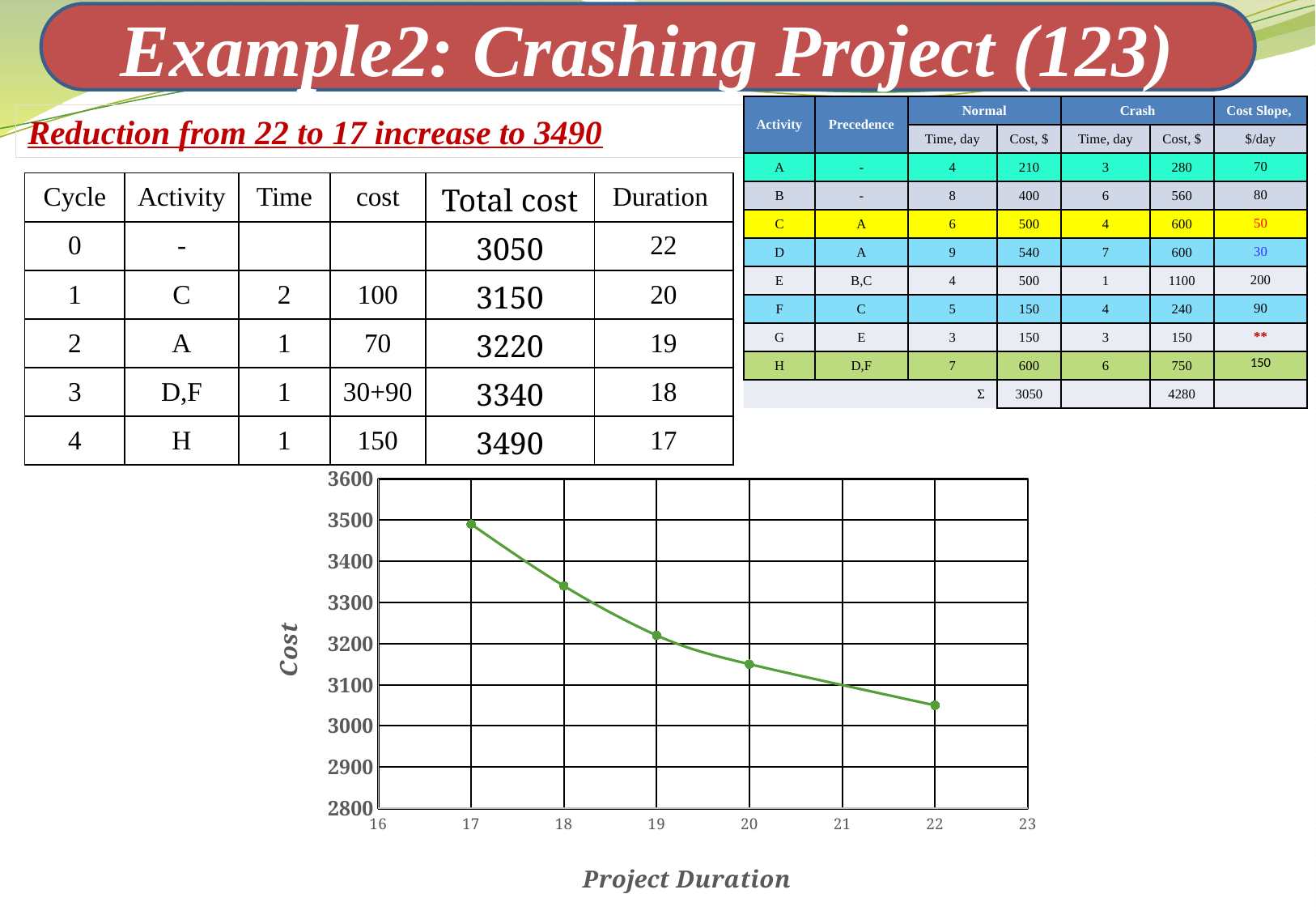
Is the cost at a project duration of 18 greater or less than 3300? greater What kind of chart is shown on the slide? line chart How many data points are plotted on the line chart? 5 Is the cost at a project duration of 22 greater or less than 3100? less Is the cost at a project duration of 17 greater or less than 3400? greater Which has the larger cost on the chart: project duration 18 or project duration 20? 18 What is the label of the y axis of the chart? Cost As project duration increases along the x axis, does the cost rise or fall? fall At which project duration is the plotted cost lowest? 22 At which project duration is the plotted cost highest? 17 What is the label of the x axis of the chart? Project Duration